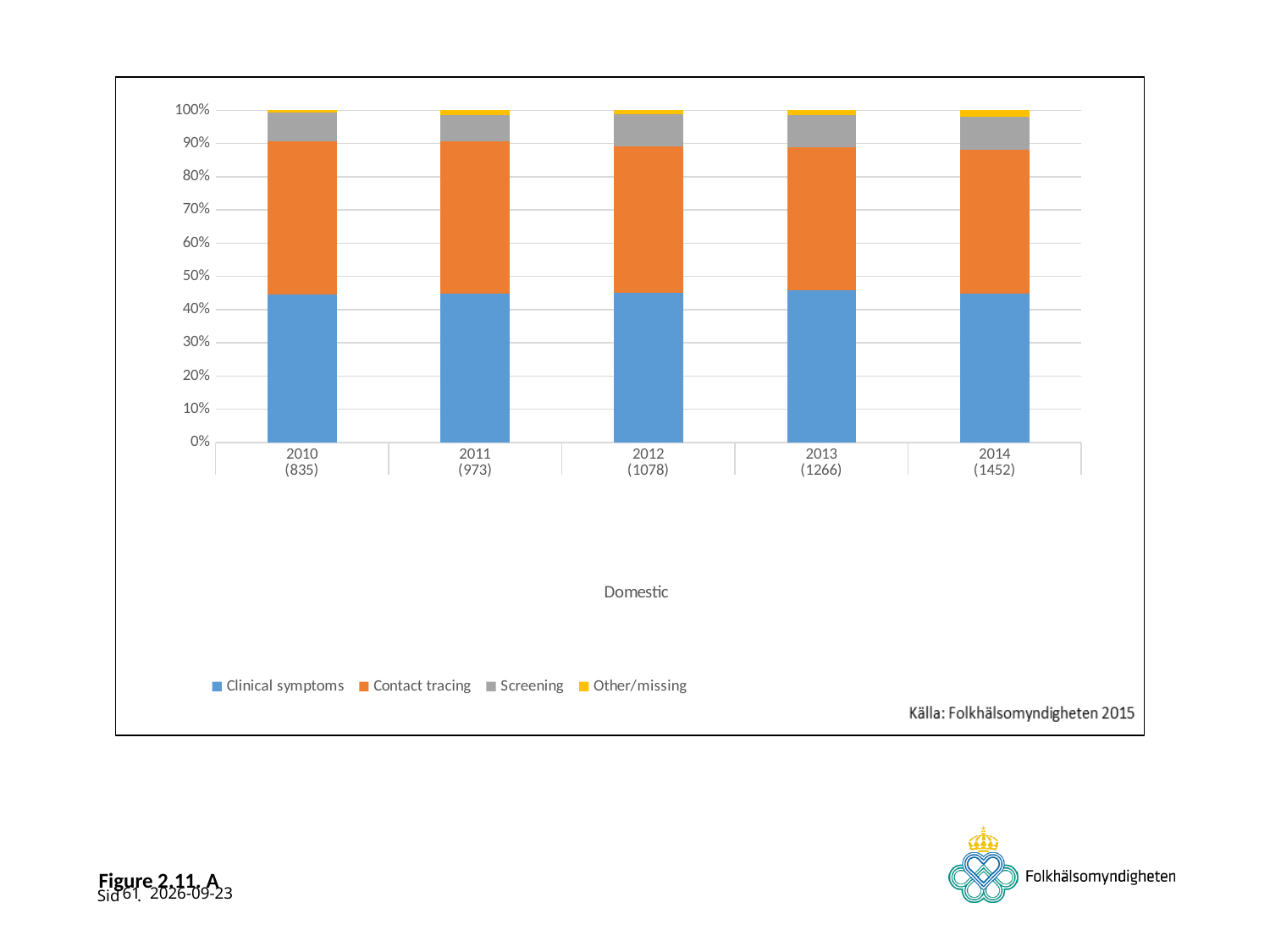
Is the Clinical symptoms share for 2013 greater or less than 40%? greater How many series does the legend list? 4 How many years (categories) are shown along the x axis? 5 What are the four series listed in the legend? Clinical symptoms, Contact tracing, Screening, Other/missing What is the difference between the numbers in parentheses for 2014 and 2010? 617 Which year has the largest number shown in parentheses? 2014 What label appears beneath the year categories on the x axis? Domestic What kind of chart is shown on the slide? Stacked bar chart What number is shown in parentheses under 2010? 835 What number is shown in parentheses under 2014? 1452 Which year has the smallest number shown in parentheses? 2010 Is the Clinical symptoms share for 2012 greater or less than 50%? less